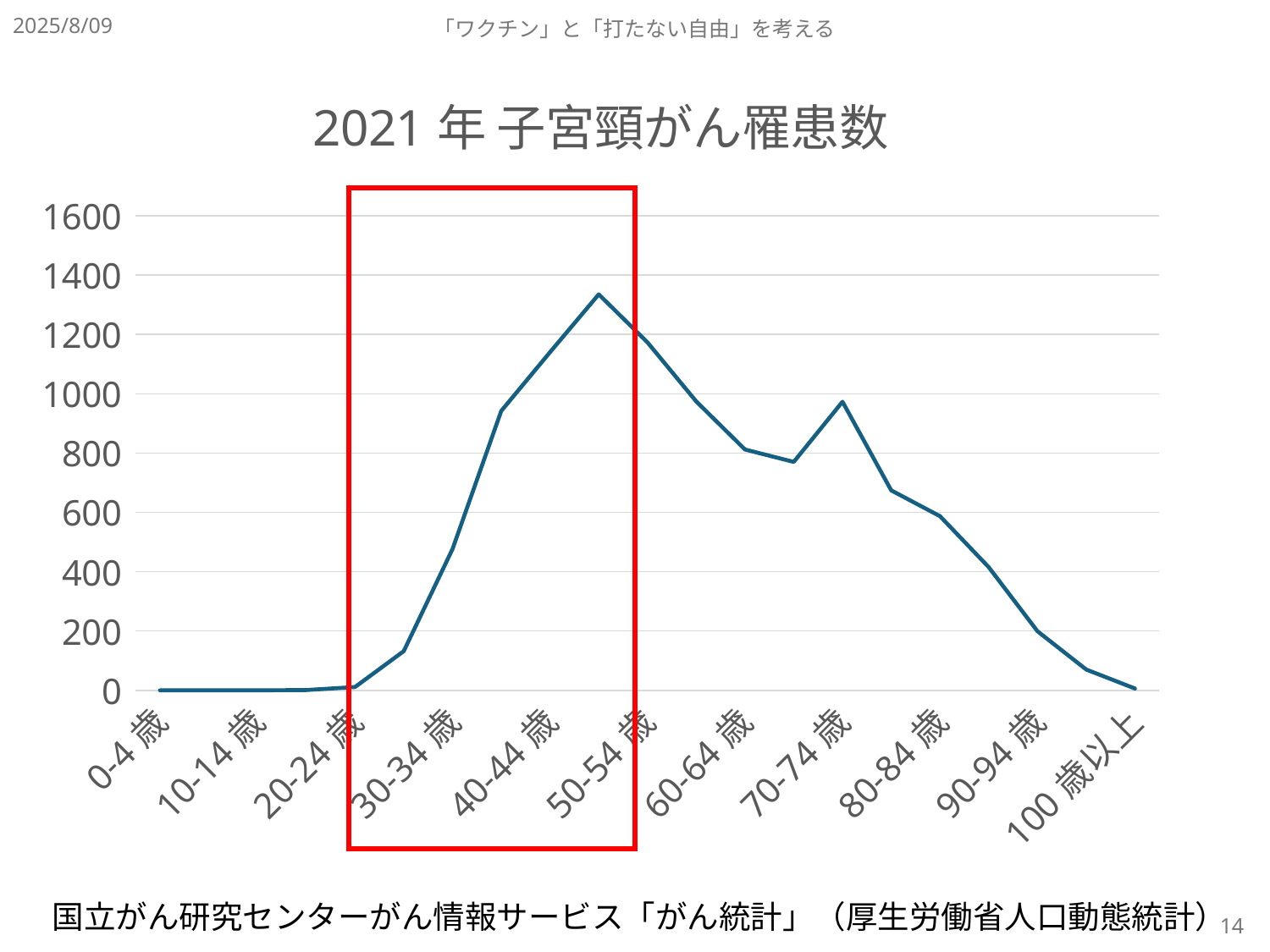
Do the values rise or fall from 20-24 歳 to 40-44 歳? rise Is the value for 60-64 歳 greater or less than 1000? less Is the value for 50-54 歳 greater or less than 1000? greater What is the title of the chart? 2021 年 子宮頸がん罹患数 Which is larger, the value for 70-74 歳 or the value for 80-84 歳? 70-74 歳 Which age range labels are enclosed by the red box on the chart? 30-34 歳, 40-44 歳, 50-54 歳 What kind of chart is shown on the slide? line chart Is the value for 30-34 歳 greater or less than 200? greater Which is larger, the value for 40-44 歳 or the value for 30-34 歳? 40-44 歳